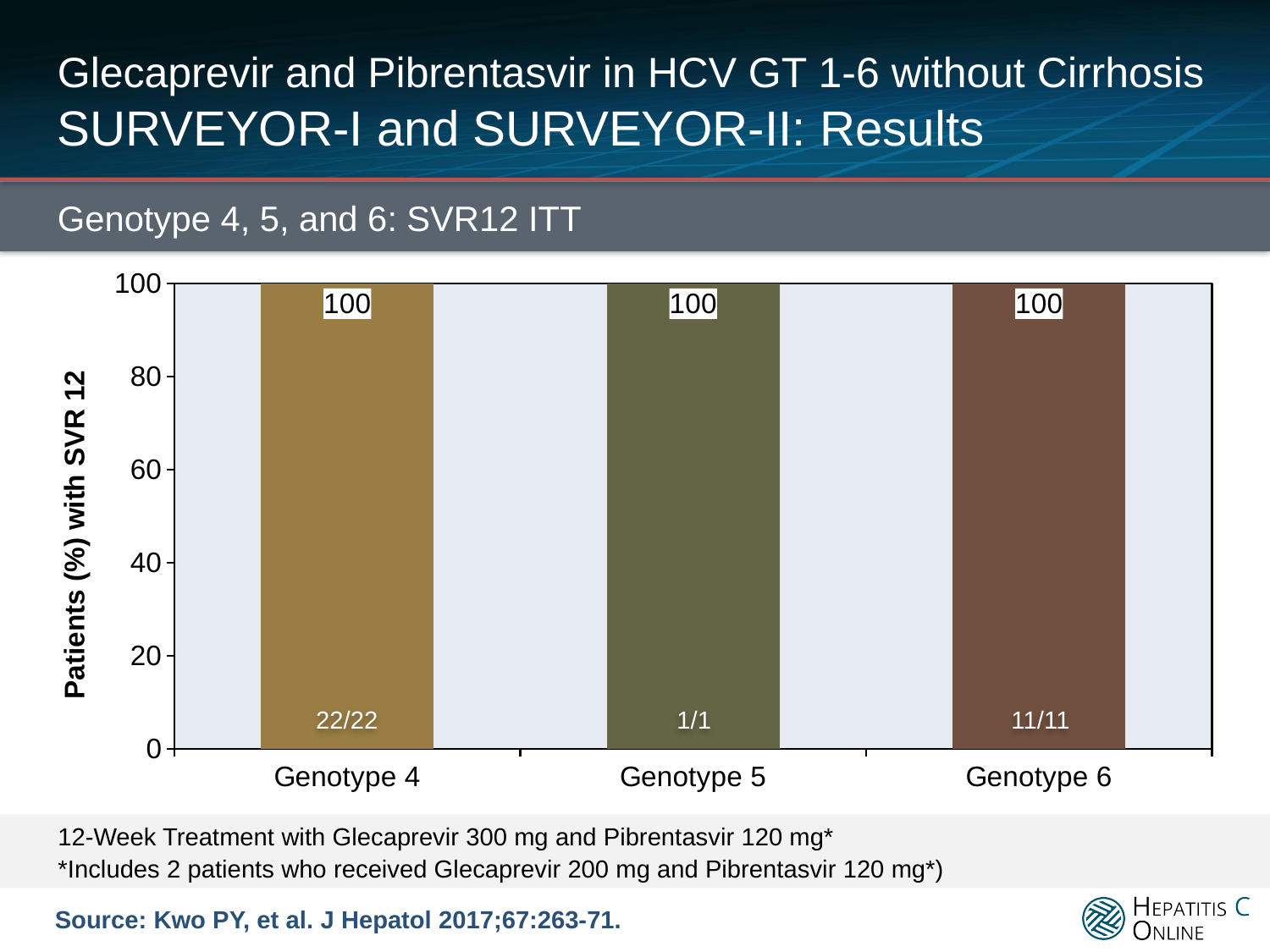
What is the SVR12 value for Genotype 5? 100 What is the label of the y axis? Patients (%) with SVR 12 What fraction of patients is shown inside the Genotype 4 bar? 22/22 What is the difference between the SVR12 values for Genotype 4 and Genotype 6? 0 What kind of chart is shown on the slide? Bar chart What is the title of the chart? Genotype 4, 5, and 6: SVR12 ITT What is the SVR12 value for Genotype 6? 100 How many genotype categories are shown on the x axis? 3 What fraction of patients is shown inside the Genotype 5 bar? 1/1 What is the SVR12 value for Genotype 4? 100 What fraction of patients is shown inside the Genotype 6 bar? 11/11 Is the value for Genotype 5 greater or less than 80? greater